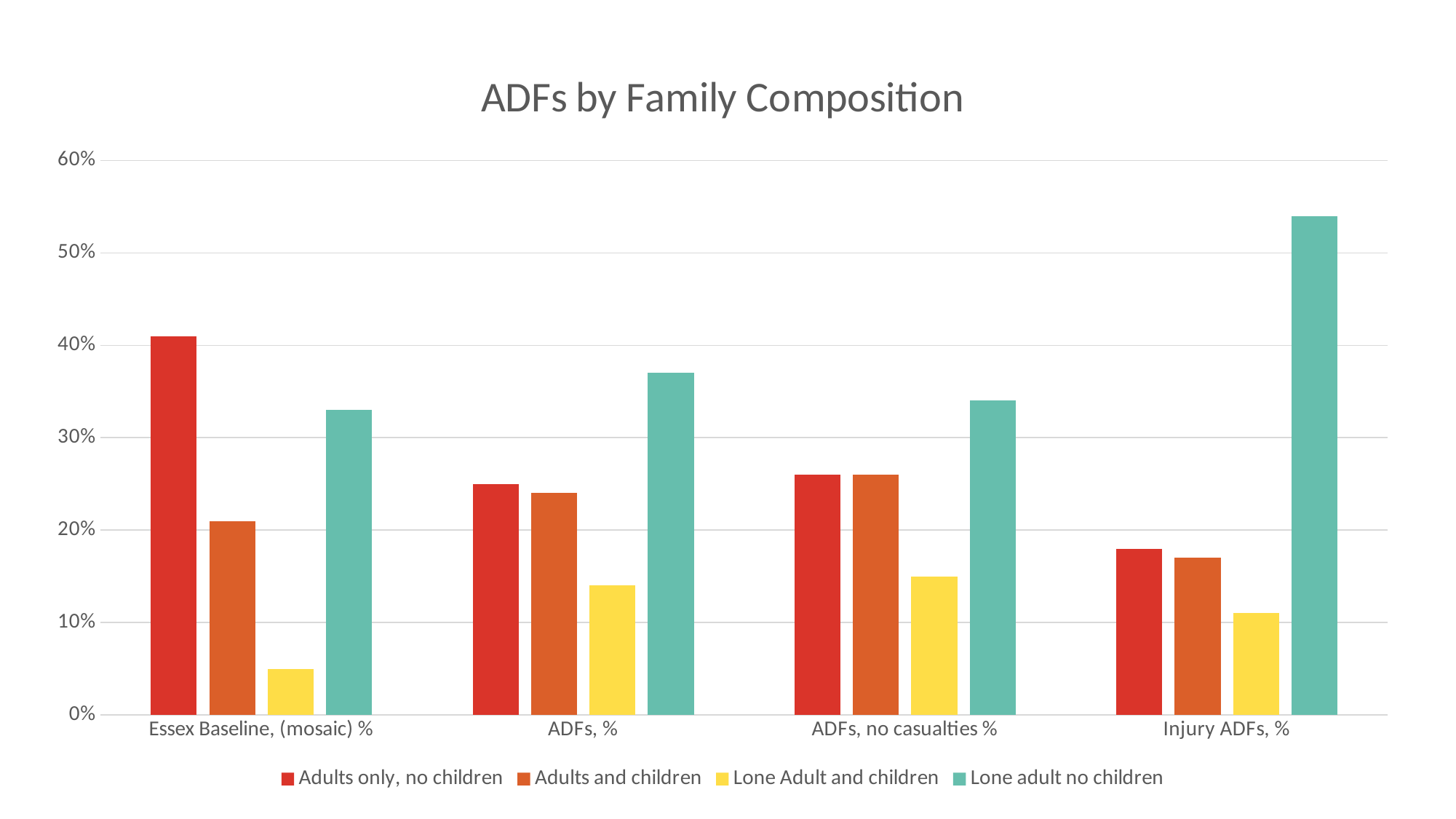
How many series does the legend list? 4 Which series has the tallest bar in the Essex Baseline, (mosaic) % category? Adults only, no children How many categories are shown on the x axis? 4 Is the value for Lone adult no children in the Injury ADFs, % category greater or less than 50%? greater In the Injury ADFs, % category, which is larger: Adults only, no children or Lone adult no children? Lone adult no children Is the value for Lone adult no children in the ADFs, % category greater or less than 30%? greater Which series has the tallest bar in the Injury ADFs, % category? Lone adult no children In the Essex Baseline, (mosaic) % category, which is larger: Adults only, no children or Adults and children? Adults only, no children What type of chart is shown on the slide? bar chart Which series has the shortest bar in the Essex Baseline, (mosaic) % category? Lone Adult and children Is the value for Lone Adult and children in the Essex Baseline, (mosaic) % category greater or less than 10%? less What is the title of the chart? ADFs by Family Composition